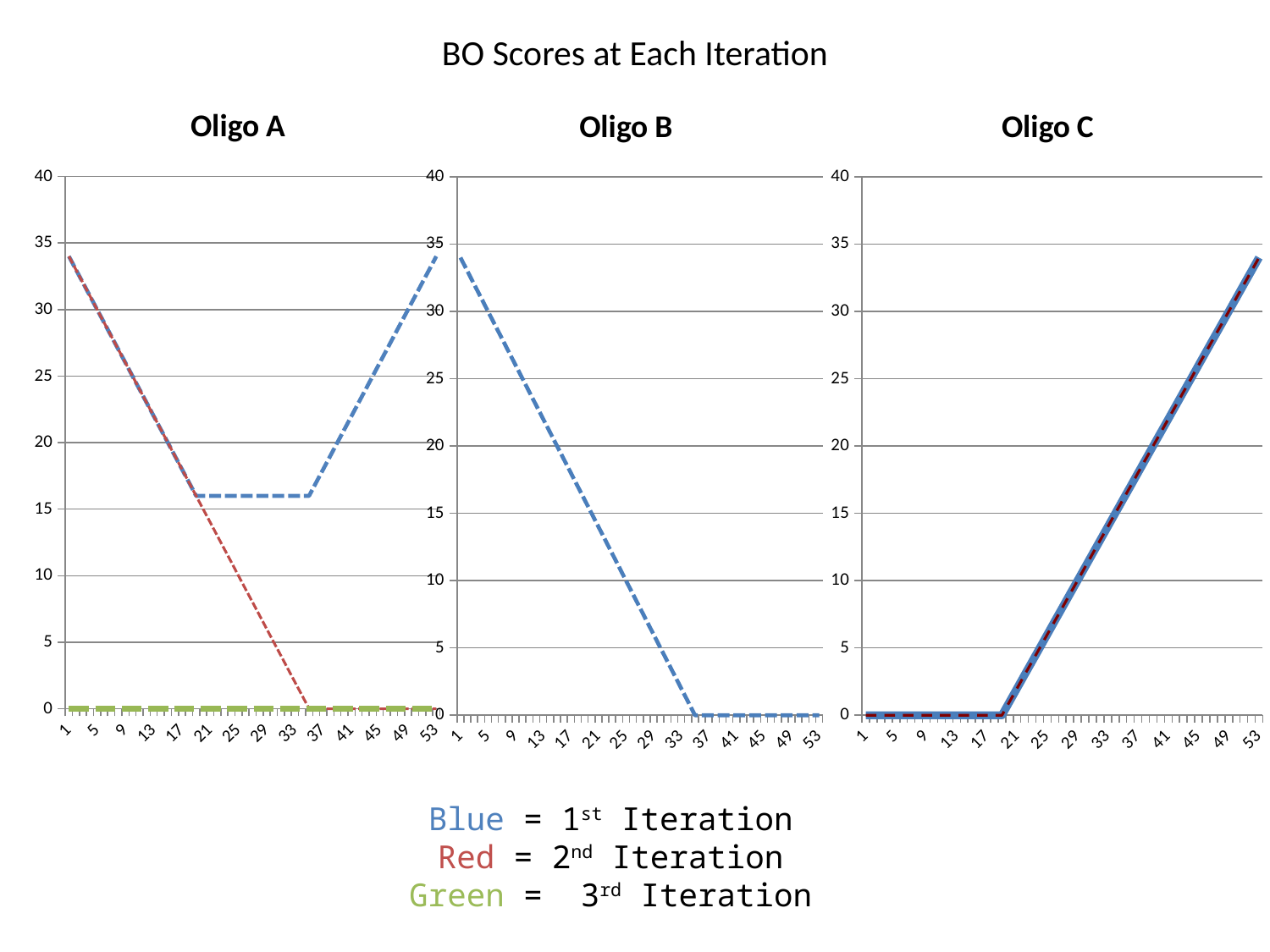
How many charts are shown on the slide? 3 In the Oligo B chart, what value does the blue line reach at iteration 45? 0 In the Oligo B chart, is the blue line's value at iteration 1 greater or less than 30? greater In the Oligo A chart, what value does the green (3rd iteration) line stay at across all iterations? 0 In the Oligo C chart, does the blue line rise or fall from iteration 21 to iteration 53? rise In the Oligo A chart, is the blue line's value at iteration 25 greater or less than 20? less In the Oligo C chart, is the value at iteration 53 greater or less than 30? greater What is the title of the slide's set of charts? BO Scores at Each Iteration In the Oligo B chart, does the blue line rise or fall from iteration 1 to iteration 37? fall What kind of chart is used for Oligo A? line chart According to the legend, which colour represents the 2nd iteration? Red In the Oligo C chart, what is the value of the lines at iteration 9? 0